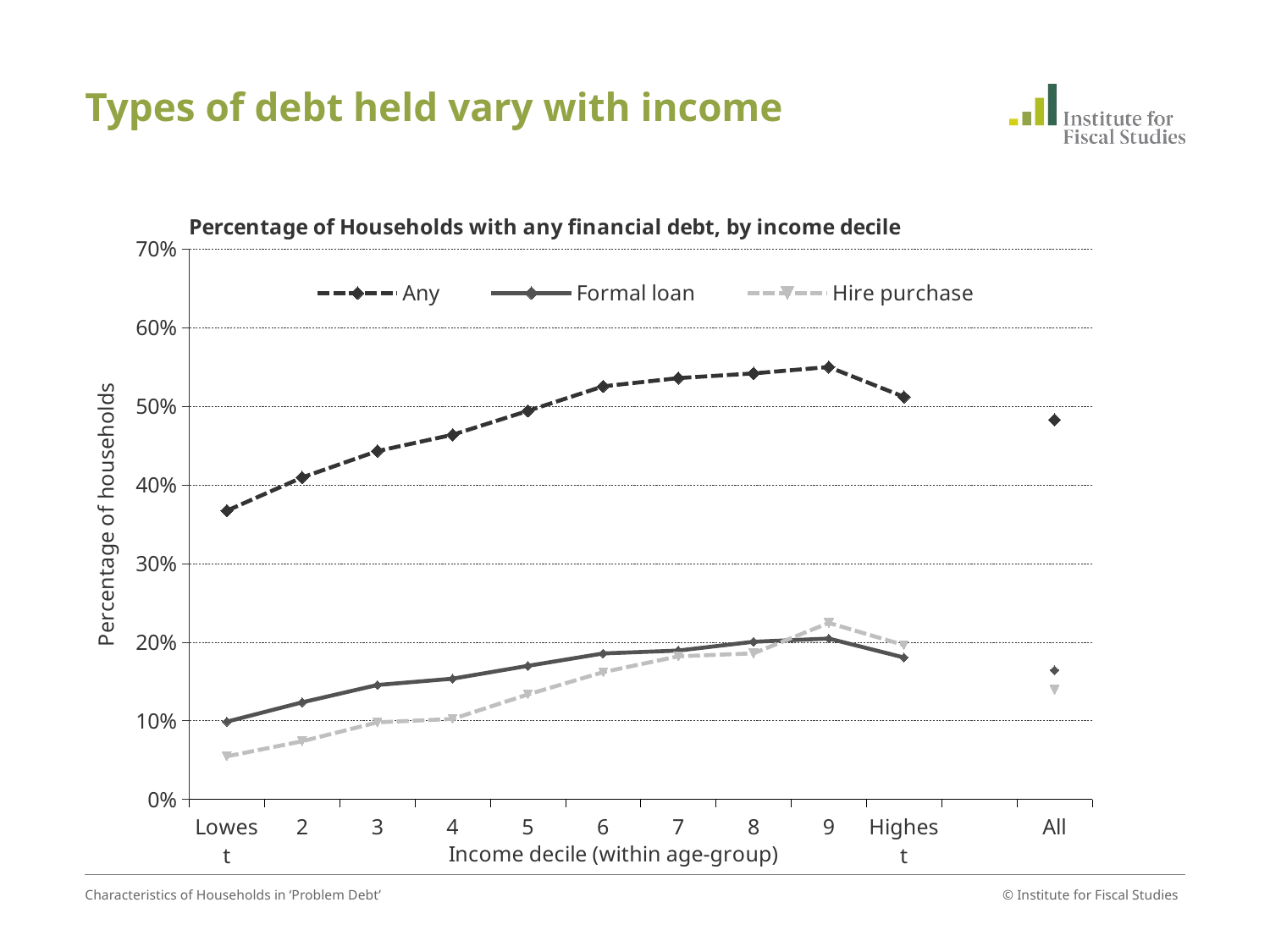
Is the value of the Any series for All greater or less than 50%? less For which income decile is the Any series at its highest? 9 For the Lowest income decile, which is larger: Formal loan or Hire purchase? Formal loan Is the value of the Any series for the Lowest income decile greater or less than 40%? less How many categories are shown along the x axis of the chart? 11 What is the title of the chart? Percentage of Households with any financial debt, by income decile What kind of chart is shown on the slide? Line chart Is the value of the Hire purchase series for the Lowest income decile greater or less than 10%? less What are the three series listed in the chart legend? Any, Formal loan, Hire purchase For which income decile is the Hire purchase series at its lowest? Lowest How many series does the chart legend list? 3